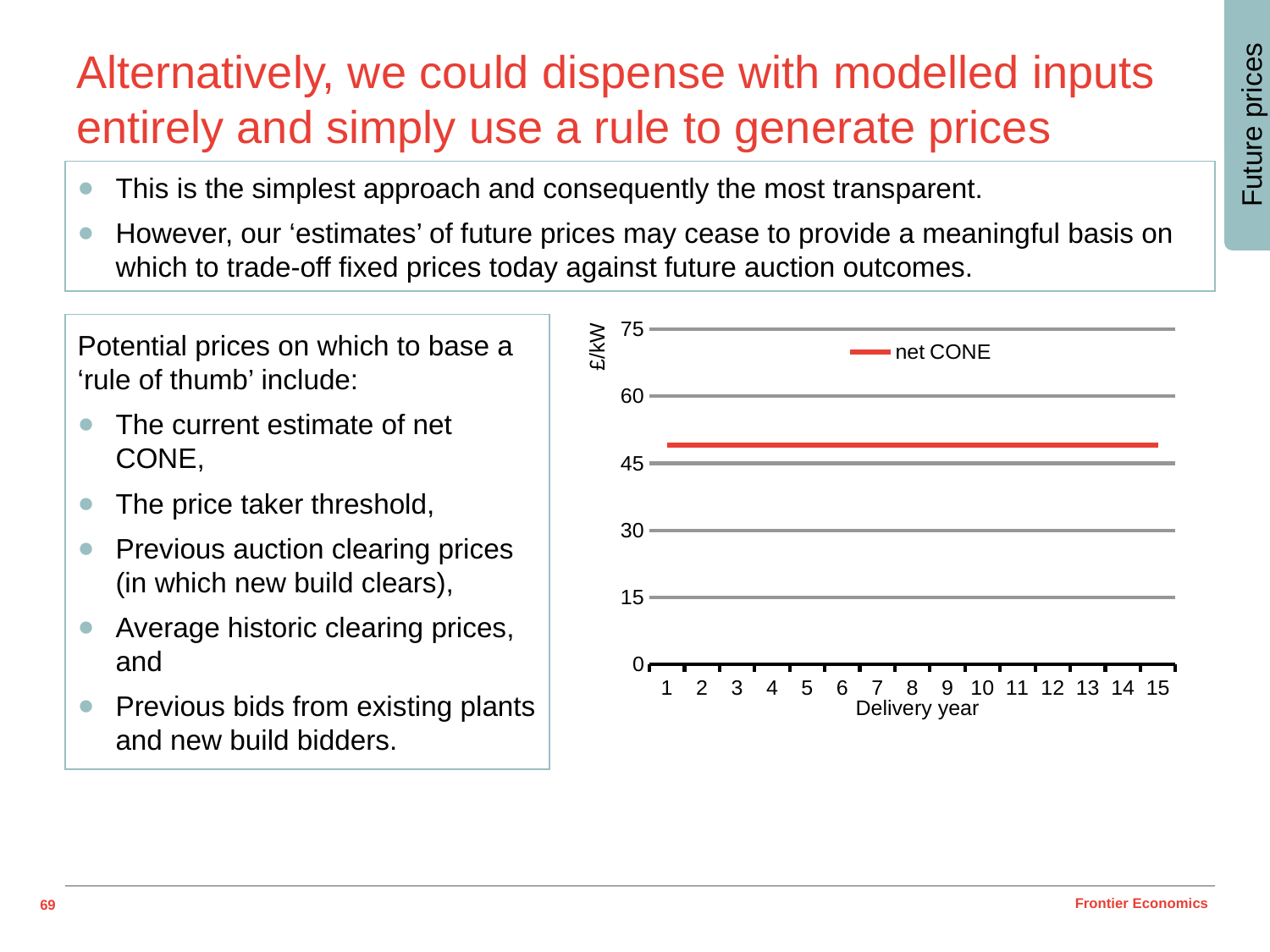
Is the net CONE value for delivery year 15 greater or less than 60? less Does the net CONE line rise, fall or stay flat across the delivery years? stays flat How many delivery years are shown on the x axis of the chart? 15 Is the net CONE value for delivery year 8 greater or less than 30? greater Is the net CONE value for delivery year 5 greater or less than 75? less What kind of chart is shown on the slide? line chart What is the label on the y axis of the chart? £/kW How many series does the chart legend list? 1 What is the name of the series shown in the chart legend? net CONE